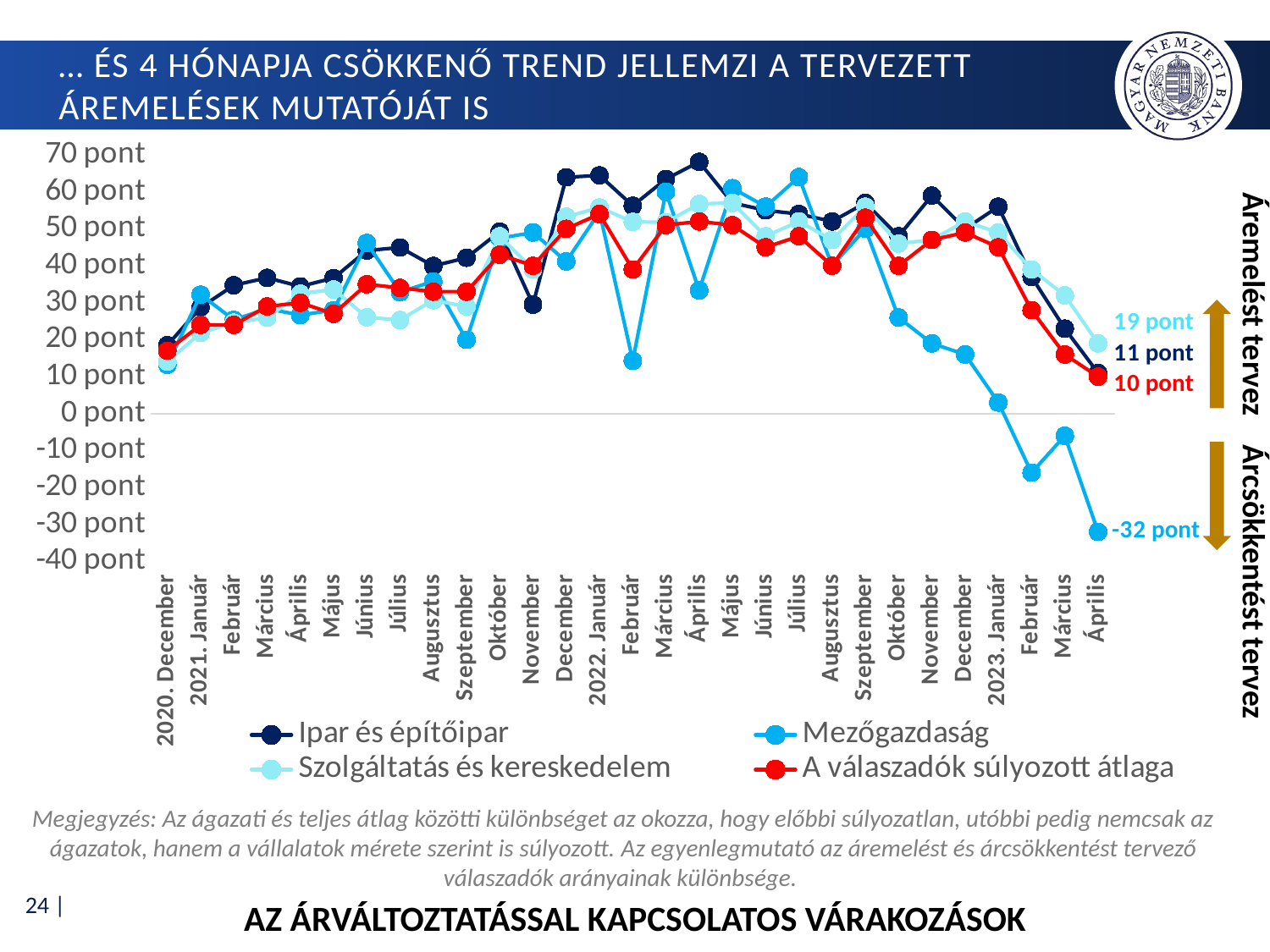
Is the value for Ipar és építőipar in Április 2022 greater or less than 60 pont? greater What is the value of A válaszadók súlyozott átlaga in Április 2023? 10 pont Does the Mezőgazdaság series rise or fall from Szeptember 2022 to Április 2023? fall Which series has the lowest value in Április 2023? Mezőgazdaság What kind of chart is shown on the slide? line chart What is the value of Szolgáltatás és kereskedelem in Április 2023? 19 pont Is the value for Mezőgazdaság in Február 2023 greater or less than -10 pont? less What is the value of Mezőgazdaság in Április 2023? -32 pont What is the difference between Szolgáltatás és kereskedelem and Mezőgazdaság in Április 2023? 51 pont What is the value of Ipar és építőipar in Április 2023? 11 pont How many series does the legend list? 4 What is the difference between Ipar és építőipar and A válaszadók súlyozott átlaga in Április 2023? 1 pont